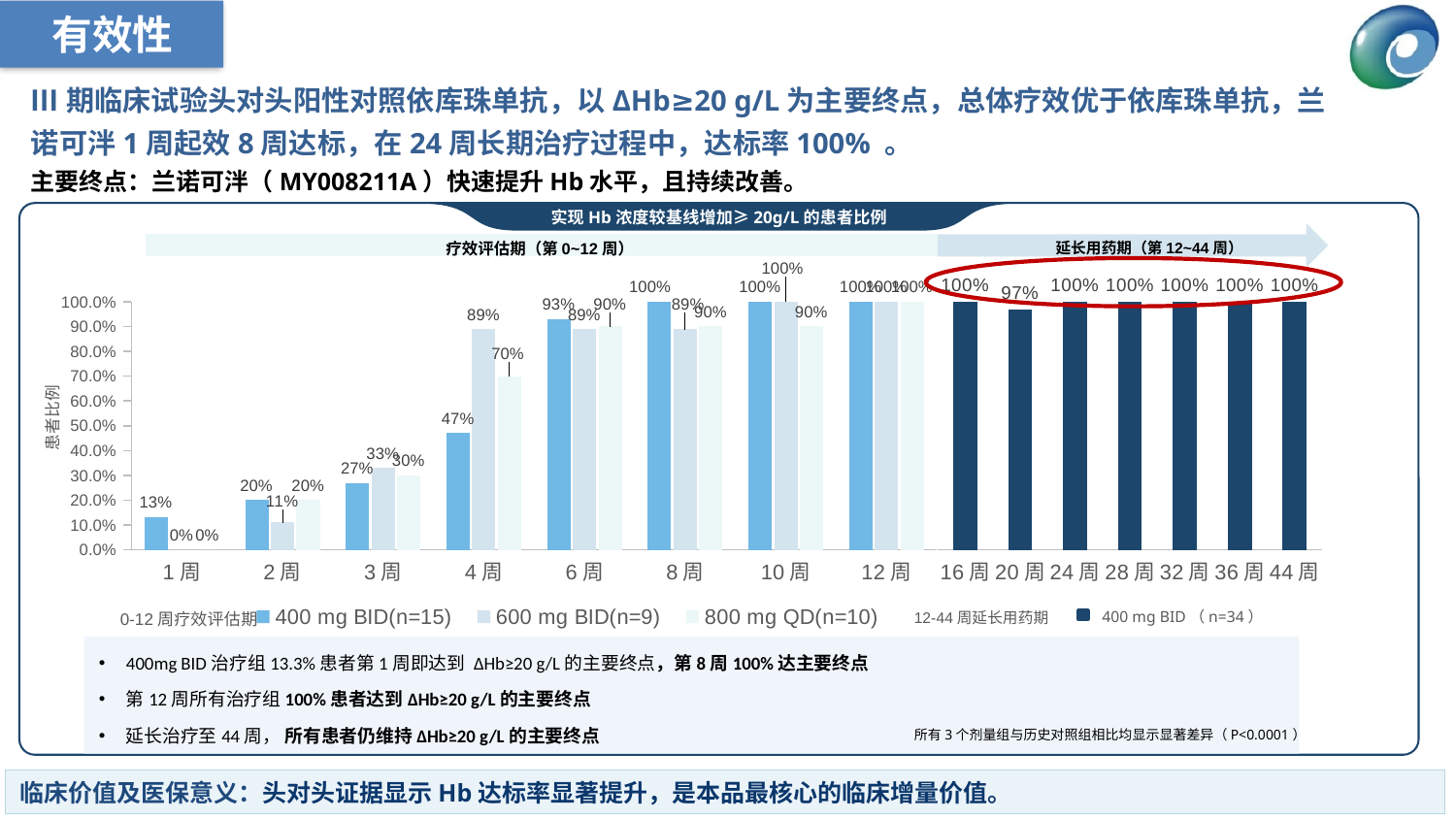
At 4 周, what is the difference between the 600 mg BID(n=9) value and the 400 mg BID(n=15) value? 42 percentage points What is the value for the 400 mg BID(n=15) series at 1 周? 13% What kind of chart is shown on the slide? Bar chart What is the value for the 600 mg BID(n=9) series at 4 周? 89% How many series does the legend list? 4 How many week categories are shown on the x axis? 15 At 3 周, which is larger: the 400 mg BID(n=15) value or the 600 mg BID(n=9) value? 600 mg BID(n=9) What is the value for the 800 mg QD(n=10) series at 4 周? 70% At which week is the 400 mg BID(n=15) value lowest? 1 周 Does the 400 mg BID(n=15) series rise or fall from 1 周 to 8 周? Rise What is the value shown for 20 周 in the extension period (400 mg BID, n=34)? 97% What is the value for the 800 mg QD(n=10) series at 10 周? 90%